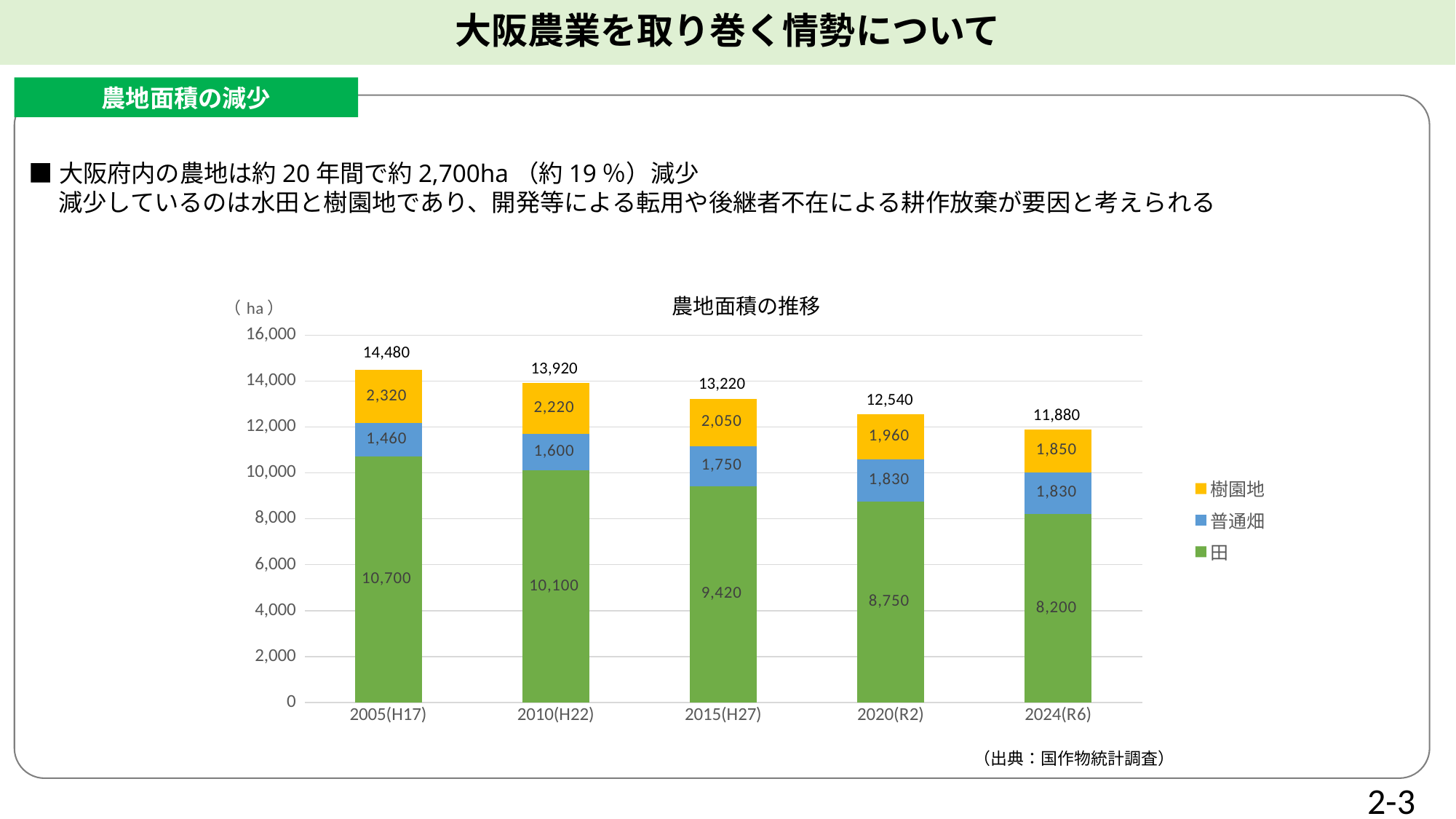
Which year has the lowest value for 田? 2024(R6) What is the value of 普通畑 for 2015(H27)? 1,750 What is the value of 樹園地 for 2024(R6)? 1,850 What is the difference between the 田 values for 2005(H17) and 2024(R6)? 2,500 What is the total of the stacked bar for 2020(R2)? 12,540 Does the total farmland area rise or fall from 2005(H17) to 2024(R6)? Fall Which year has the highest total farmland area? 2005(H17) Which is larger, the 樹園地 value for 2010(H22) or for 2015(H27)? 2010(H22) How many series does the legend list? 3 What kind of chart is shown? Stacked bar chart How many years are shown on the x axis? 5 What is the value of 田 for 2005(H17)? 10,700